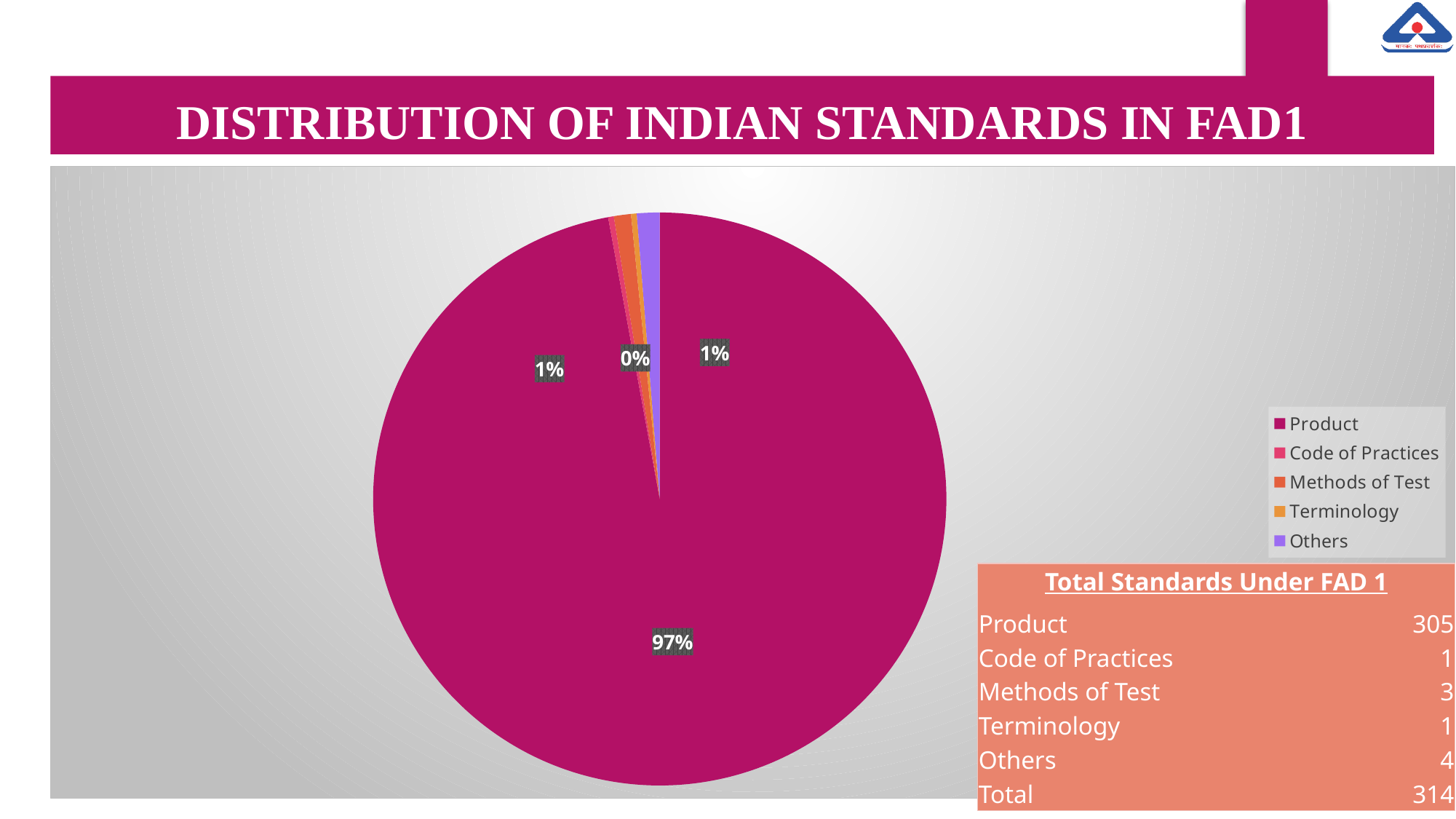
Which category has the largest slice of the pie? Product What is the difference in percentage points between the Product slice (97%) and the Others slice (1%)? 96 How many categories does the legend list? 5 What share of the pie is labelled for the Methods of Test slice? 1% Which legend entry is listed first? Product Is the share for Product greater or less than 50%? greater What share of the pie is labelled for the Others slice? 1% What kind of chart is shown on the slide? Pie chart Which is larger, the Product slice or the Others slice? Product What percentage of the pie does the Product slice represent? 97% What is the title of the chart on the slide? DISTRIBUTION OF INDIAN STANDARDS IN FAD1